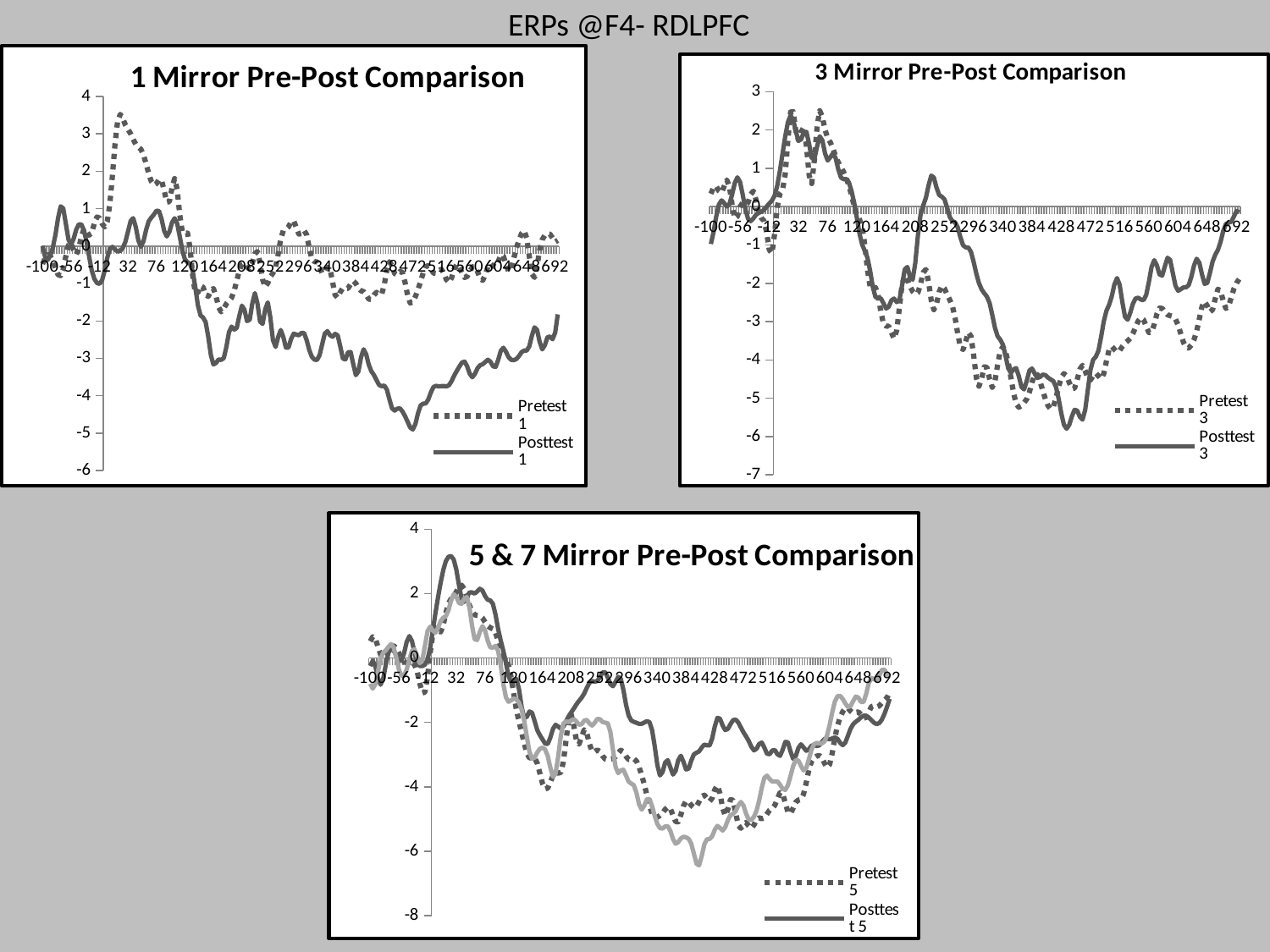
In the "3 Mirror Pre-Post Comparison" chart, is the highest value of the Pretest 3 line greater or less than 2? greater What kind of chart is the "3 Mirror Pre-Post Comparison" chart? line chart In the "1 Mirror Pre-Post Comparison" chart, which series is drawn with a dotted line? Pretest 1 In the "5 & 7 Mirror Pre-Post Comparison" chart, is the highest value of the Posttest 5 line greater or less than 2? greater In the "1 Mirror Pre-Post Comparison" chart, which series reaches the higher peak, Pretest 1 or Posttest 1? Pretest 1 In the "1 Mirror Pre-Post Comparison" chart, is the lowest value of the Posttest 1 line greater or less than -4? less How many series does the legend of the "1 Mirror Pre-Post Comparison" chart list? 2 What is the title of the chart at the bottom of the slide? 5 & 7 Mirror Pre-Post Comparison How many series does the legend of the "3 Mirror Pre-Post Comparison" chart list? 2 What kind of chart is the "1 Mirror Pre-Post Comparison" chart? line chart